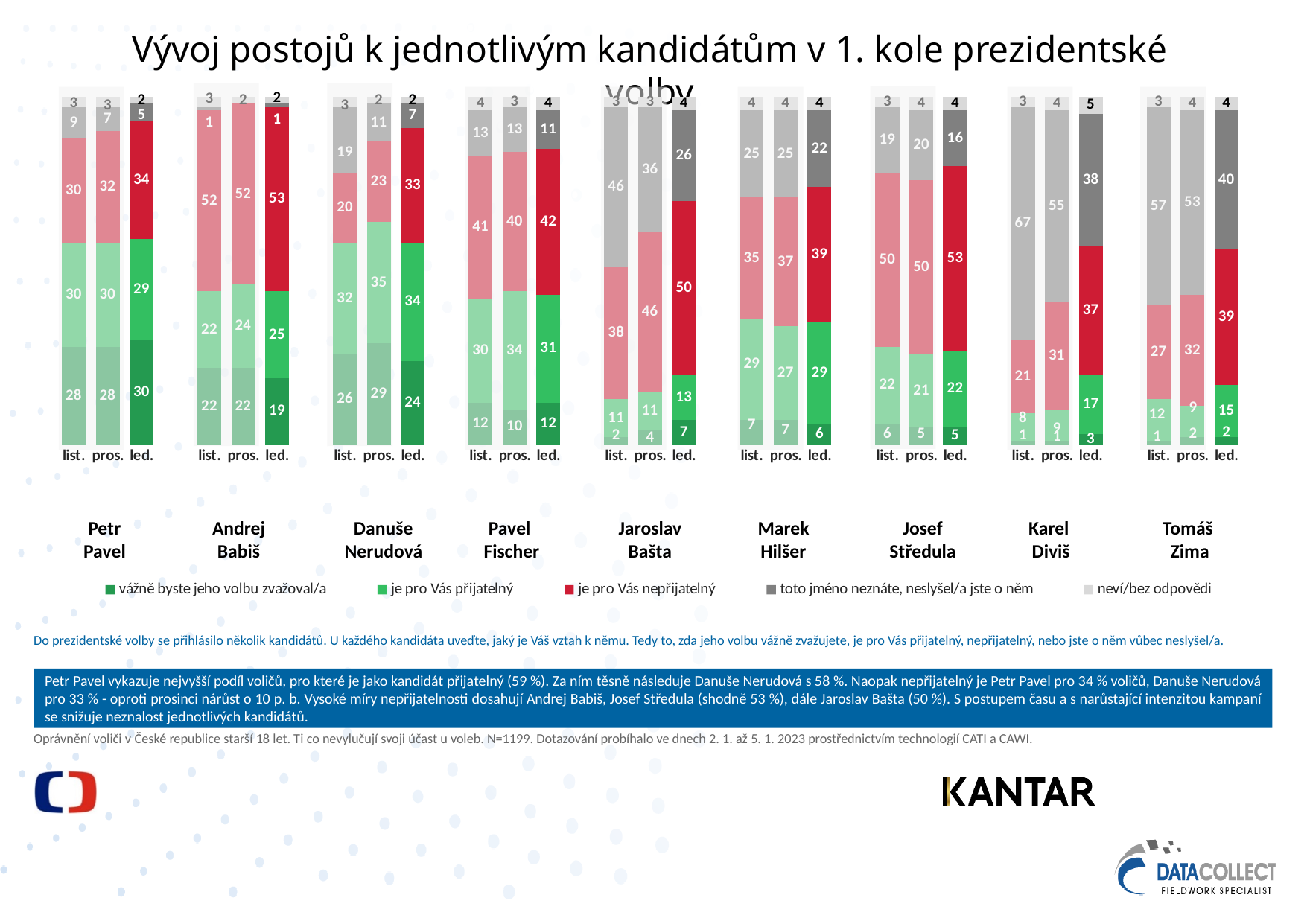
In the led. bars, who has the larger "je pro Vás nepřijatelný" value, Jaroslav Bašta or Marek Hilšer? Jaroslav Bašta Which candidate has the lowest value of "vážně byste jeho volbu zvažoval/a" in the led. bar? Tomáš Zima Does the "neví/bez odpovědi" value for Karel Diviš rise or fall from list. to led.? fall By how much did the "je pro Vás nepřijatelný" value for Danuše Nerudová change from pros. to led.? 10 What is the value of "je pro Vás nepřijatelný" for Petr Pavel in the led. bar? 34 How many candidates are shown in the chart? 9 What kind of chart is shown on the slide? stacked bar chart What is the total of the led. stacked bar for Petr Pavel? 100 Which candidate has the highest value of "vážně byste jeho volbu zvažoval/a" in the led. bar? Petr Pavel How many series does the legend list? 5 What is the value of "neví/bez odpovědi" for Karel Diviš in the list. bar? 3 What is the value of "toto jméno neznáte, neslyšel/a jste o něm" for Tomáš Zima in the led. bar? 40